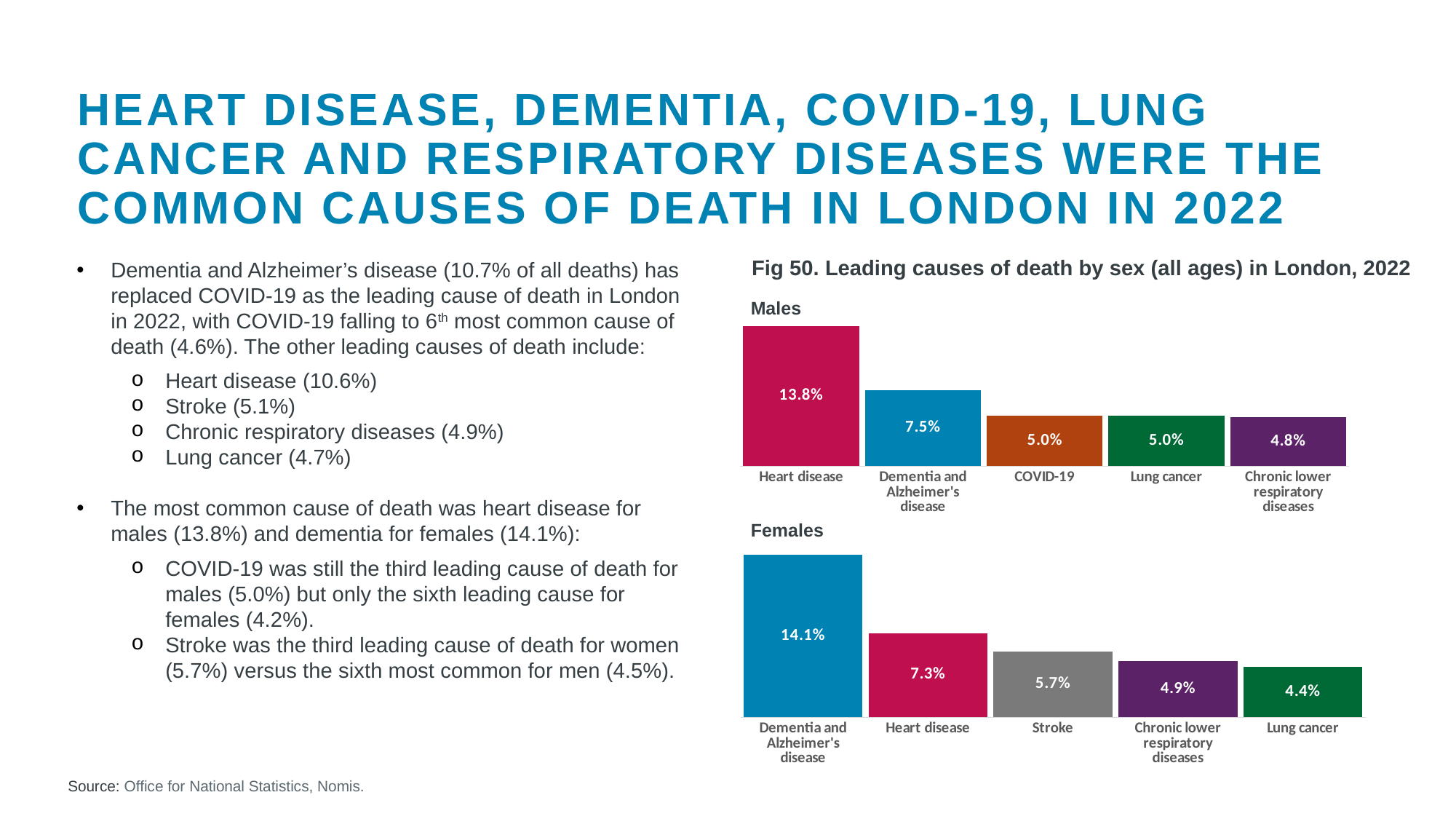
What kind of chart is used for the Males data? Bar chart What is the title of the figure containing the two charts? Fig 50. Leading causes of death by sex (all ages) in London, 2022 In the Females chart, which cause of death has the lowest value? Lung cancer In the Males chart, what is the value for Chronic lower respiratory diseases? 4.8% In the Males chart, what is the difference between Heart disease and Dementia and Alzheimer's disease? 6.3% In the Males chart, what is the value for Heart disease? 13.8% In the Males chart, which cause of death has the lowest value? Chronic lower respiratory diseases Which is larger: Heart disease in the Males chart or Heart disease in the Females chart? Males In the Females chart, what is the value for Stroke? 5.7% How many causes of death are shown in the Females chart? 5 In the Females chart, which cause of death has the highest value? Dementia and Alzheimer's disease In the Females chart, what is the difference between Dementia and Alzheimer's disease and Heart disease? 6.8%